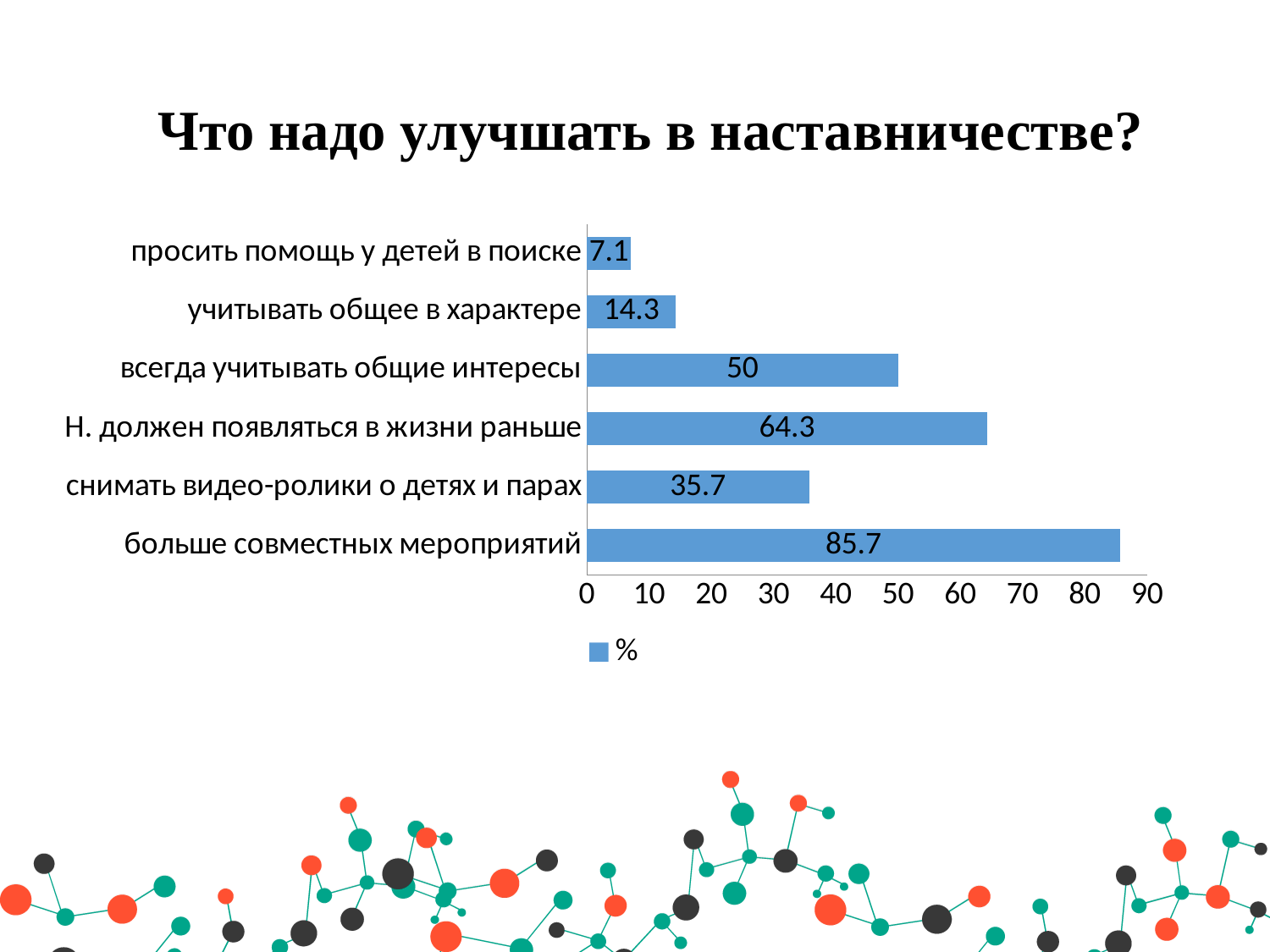
What is the value for "больше совместных мероприятий"? 85.7 How many categories are shown in the chart? 6 Which category has the lowest value? просить помощь у детей в поиске What is the value for "просить помощь у детей в поиске"? 7.1 How many series does the legend list? 1 What is the difference between the values for "больше совместных мероприятий" and "Н. должен появляться в жизни раньше"? 21.4 What kind of chart is shown on the slide? bar chart Which category has the highest value? больше совместных мероприятий What is the value for "снимать видео-ролики о детях и парах"? 35.7 What is the title of the slide? Что надо улучшать в наставничестве? Which is larger: the value for "всегда учитывать общие интересы" or "снимать видео-ролики о детях и парах"? всегда учитывать общие интересы What is the value for "Н. должен появляться в жизни раньше"? 64.3